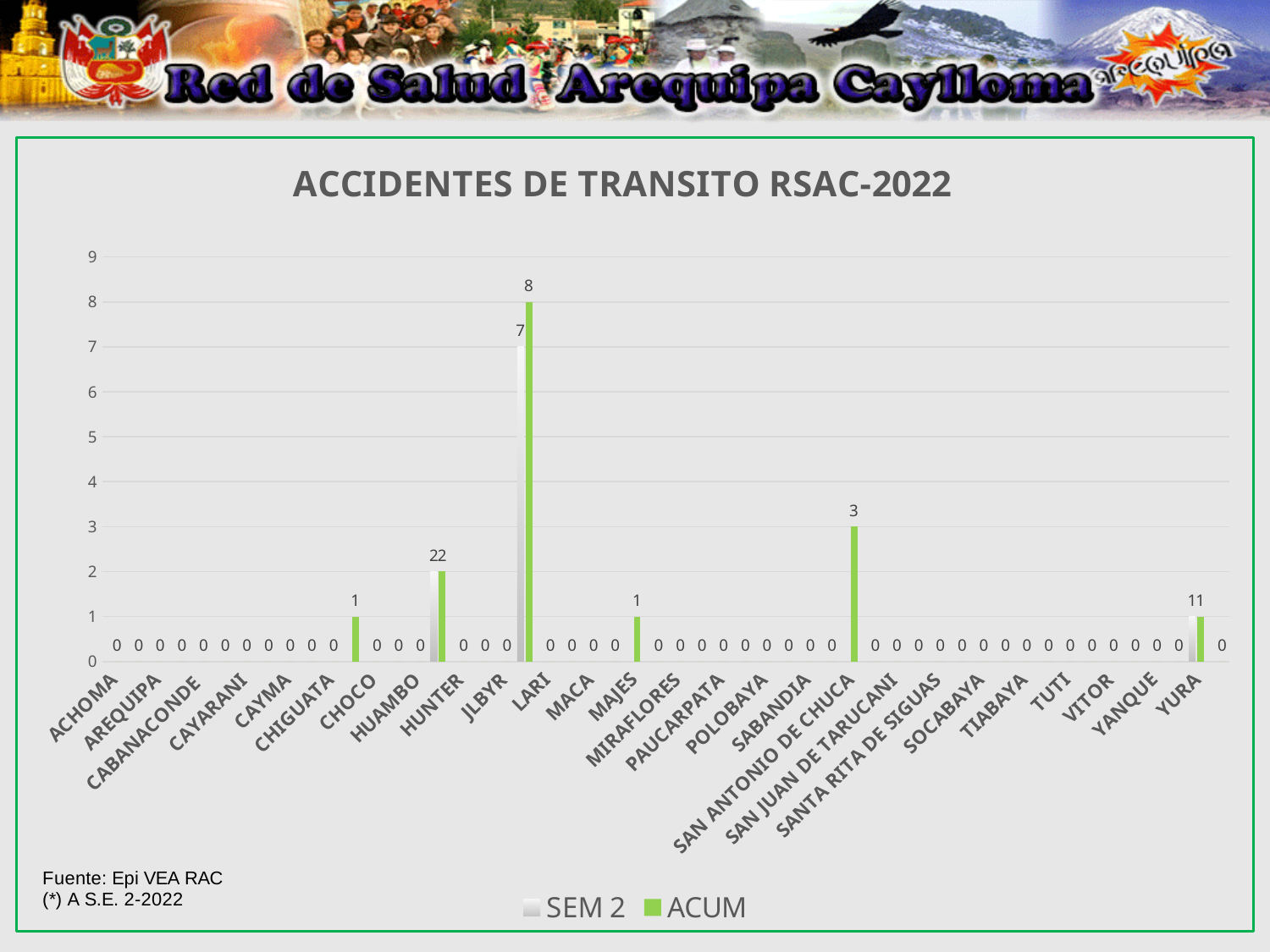
What is the title of the chart? ACCIDENTES DE TRANSITO RSAC-2022 What type of chart is shown on the slide? bar chart How many series does the legend list? 2 What is the ACUM value for SAN ANTONIO DE CHUCA? 3 What are the two series named in the legend? SEM 2 and ACUM How many categories are shown on the x axis? 26